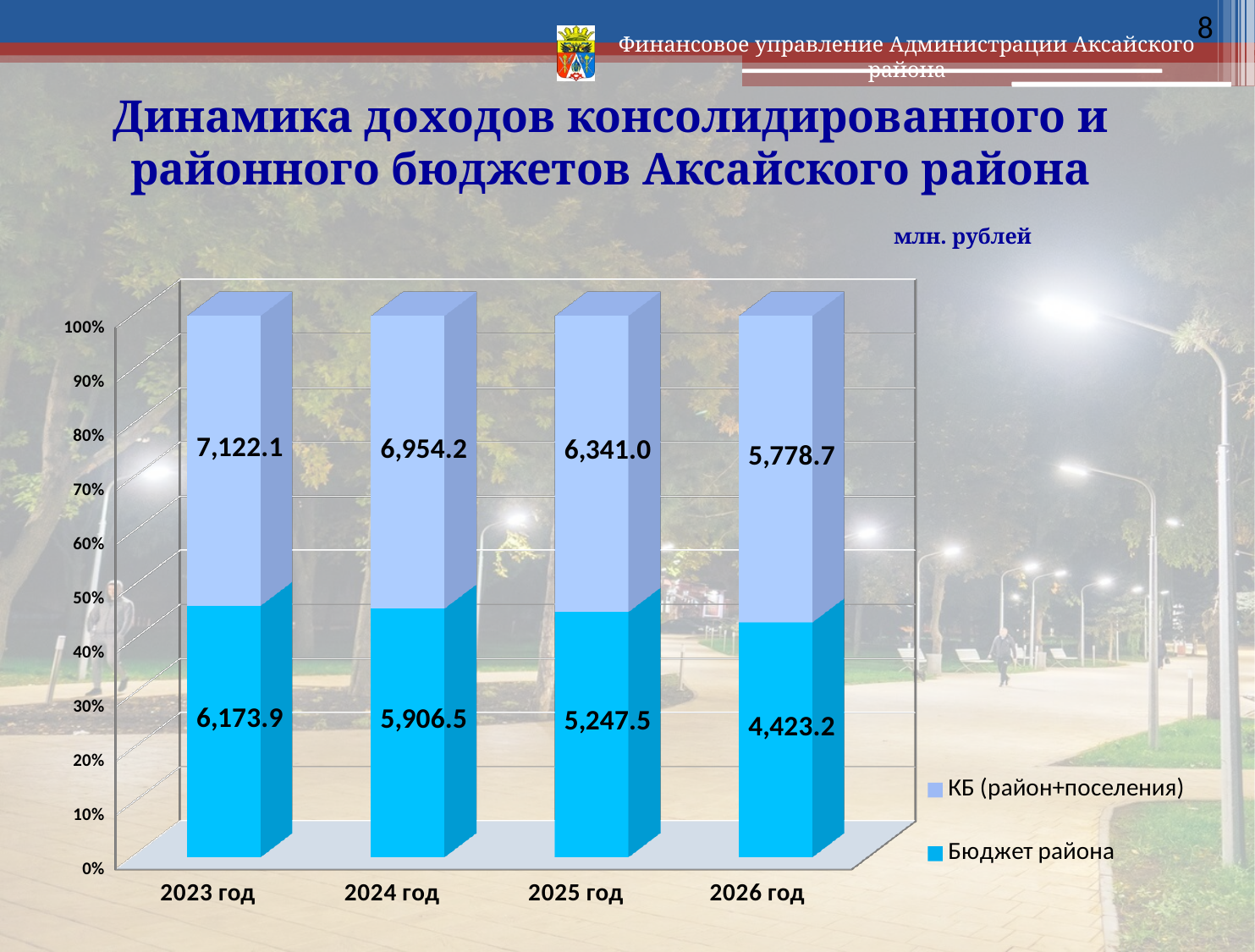
How many years are shown on the x axis? 4 Do the values for КБ (район+поселения) rise or fall from 2023 год to 2026 год? fall What is the value for Бюджет района in 2026 год? 4,423.2 What is the difference between КБ (район+поселения) and Бюджет района in 2023 год? 948.2 Which year has the larger value for Бюджет района, 2024 год or 2025 год? 2024 год How many series does the legend list? 2 By how much does the value for КБ (район+поселения) decrease from 2024 год to 2025 год? 613.2 In which year is the value for Бюджет района the lowest? 2026 год In which year is the value for КБ (район+поселения) the highest? 2023 год What is the value for Бюджет района in 2024 год? 5,906.5 What is the value for КБ (район+поселения) in 2023 год? 7,122.1 What is the value for КБ (район+поселения) in 2025 год? 6,341.0